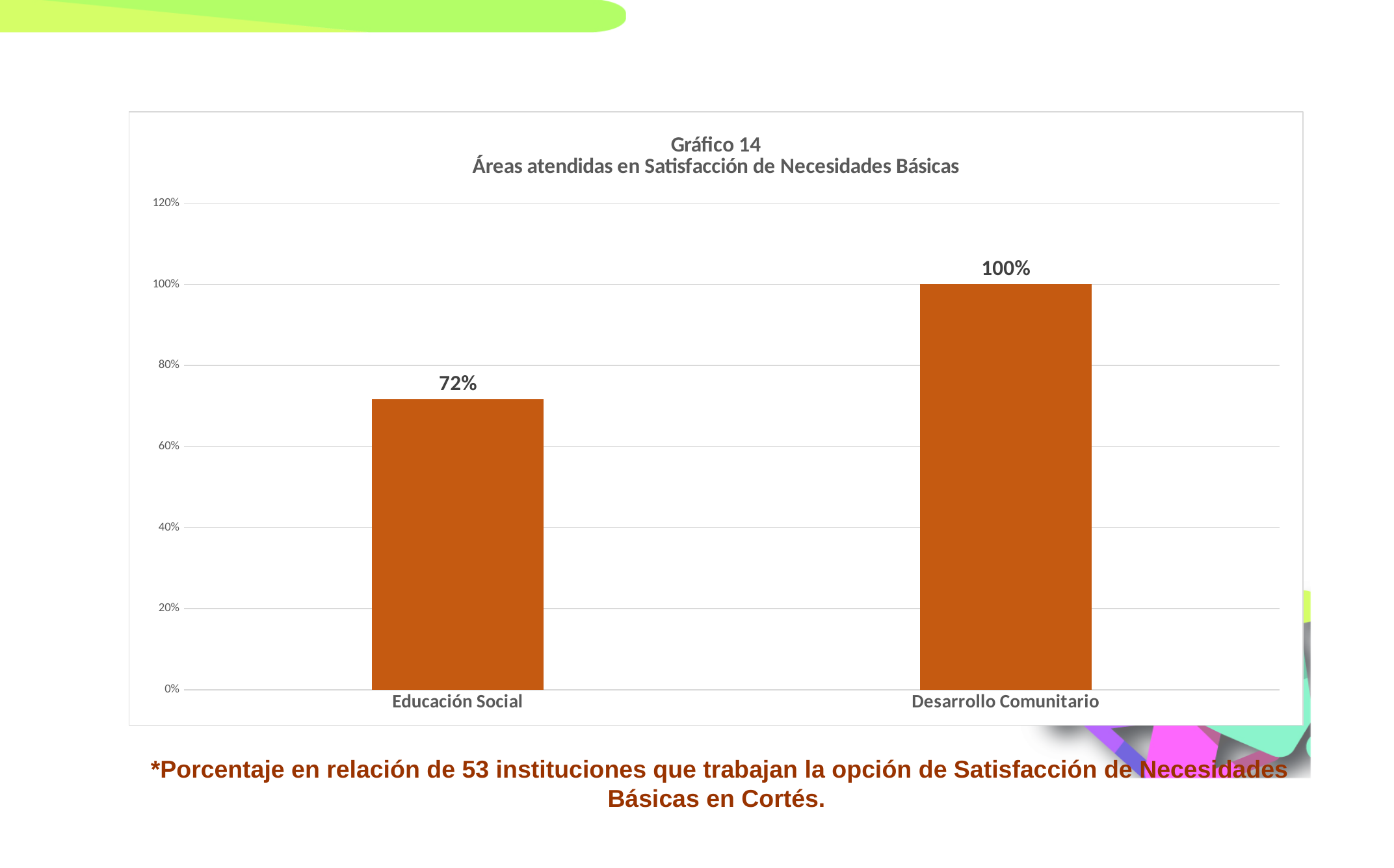
What is the value for Desarrollo Comunitario? 100% How many categories are shown in the chart? 2 Is the value for Educación Social greater or less than 80%? less What is the title of the chart? Gráfico 14 Áreas atendidas en Satisfacción de Necesidades Básicas Which is larger, the value for Educación Social or the value for Desarrollo Comunitario? Desarrollo Comunitario What is the value for Educación Social? 72% What is the highest value shown on the y axis? 120% What kind of chart is shown on the slide? bar chart Do the values rise or fall from left to right along the x axis? rise Which category has the highest value? Desarrollo Comunitario What is the difference between the values for Desarrollo Comunitario and Educación Social? 28% Which category has the lowest value? Educación Social